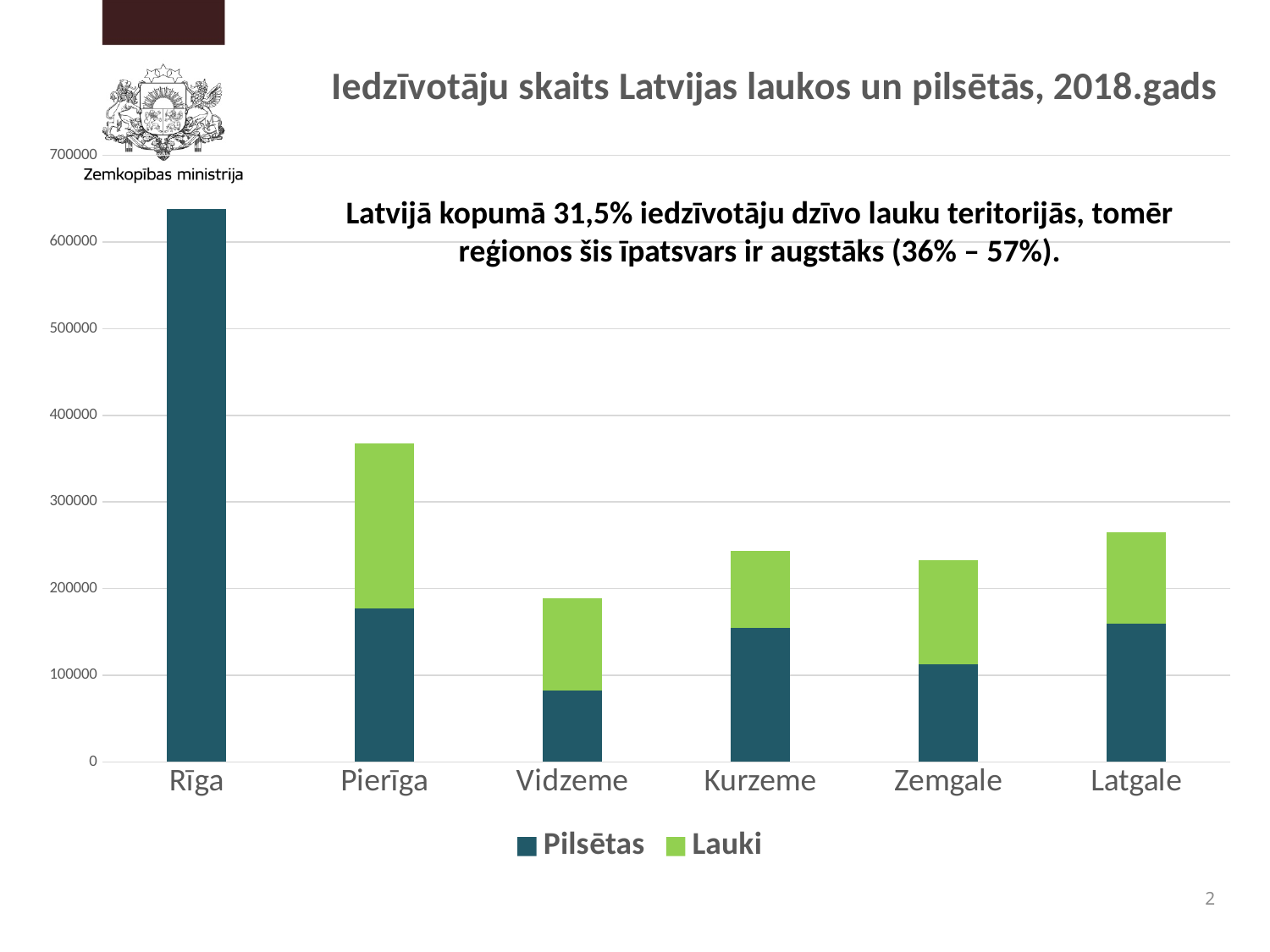
What kind of chart is shown on the slide? Stacked bar chart What is the title of the chart on the slide? Iedzīvotāju skaits Latvijas laukos un pilsētās, 2018.gads Which region has a larger Pilsētas segment, Zemgale or Latgale? Latgale Which has a larger total bar, Pierīga or Kurzeme? Pierīga How many regions are shown on the x axis of the chart? 6 Is the total bar for Latgale greater or less than 200000? greater How many series does the chart legend list? 2 Which region has the tallest bar in the chart? Rīga Is the Pilsētas value for Vidzeme greater or less than 100000? less Is the total bar for Pierīga greater or less than 400000? less Which region has the shortest total bar in the chart? Vidzeme